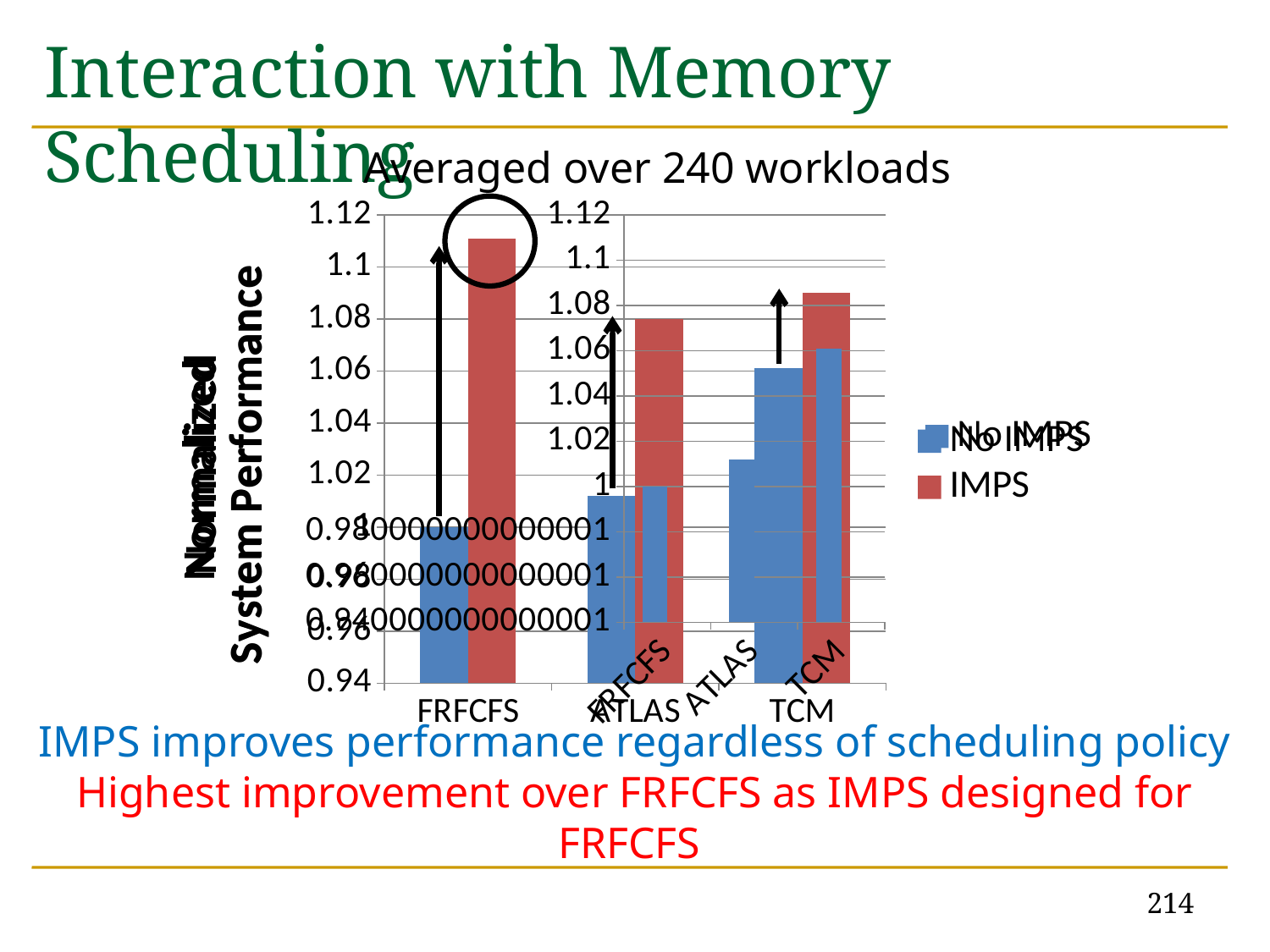
For FRFCFS, which is larger: the IMPS value or the No IMPS value? IMPS For TCM, which is larger: the IMPS value or the No IMPS value? IMPS Which category has the highest No IMPS value in the chart? TCM How many scheduling policy categories are shown on the x axis of the chart? 3 Is the No IMPS value for TCM greater or less than 1.04? greater What are the two series named in the chart legend? No IMPS and IMPS What type of chart is shown on the slide? bar chart Is the No IMPS value for FRFCFS greater or less than 1.04? less How many series does the chart legend list? 2 What is the title of the chart? Averaged over 240 workloads Which category has the highest IMPS value in the chart? FRFCFS Is the IMPS value for FRFCFS greater or less than 1.1? greater